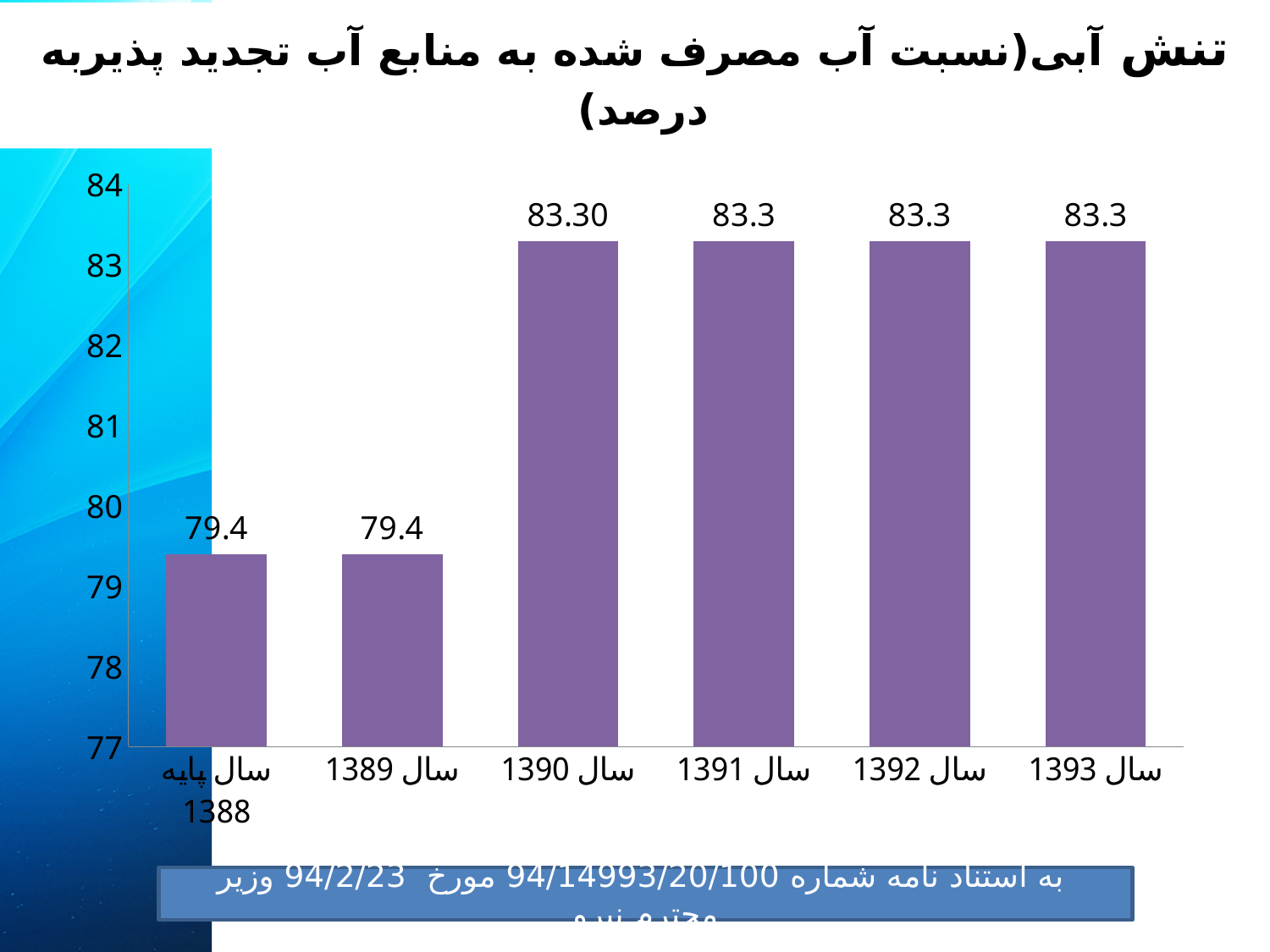
What is the value for سال 1389? 79.4 Which is larger, the value for سال 1391 or the value for سال پایه 1388? سال 1391 What is the value for سال 1393? 83.3 Is the value for سال 1392 greater or less than 83? greater Is the value for سال 1389 greater or less than 80? less What kind of chart is shown on the slide? bar chart What is the difference between the values for سال 1390 and سال 1389? 3.9 How many bars are shown in the chart? 6 What colour are the bars in the chart? purple What is the value for سال پایه 1388? 79.4 What is the value for سال 1390? 83.30 Do the values rise or fall from سال پایه 1388 to سال 1393? rise